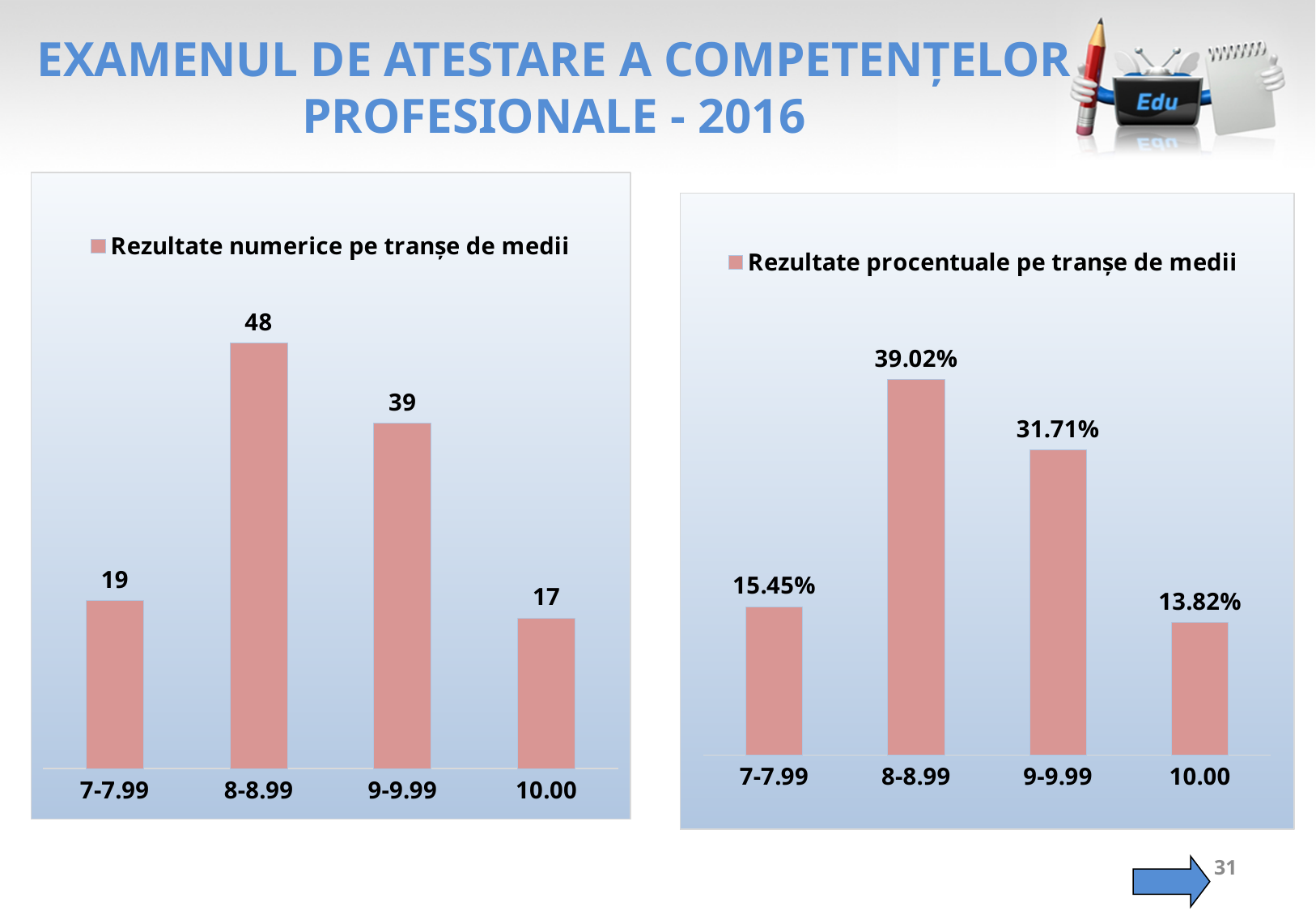
In the left chart (Rezultate numerice pe tranșe de medii), which is larger, the value for 7-7.99 or the value for 10.00? 7-7.99 What kind of chart is the right chart (Rezultate procentuale pe tranșe de medii)? Bar chart In the left chart (Rezultate numerice pe tranșe de medii), what is the value for 10.00? 17 In the right chart (Rezultate procentuale pe tranșe de medii), what is the value for 7-7.99? 15.45% How many series does the legend of the left chart list? 1 What is the legend entry of the left chart? Rezultate numerice pe tranșe de medii In the left chart (Rezultate numerice pe tranșe de medii), which category has the highest value? 8-8.99 In the left chart (Rezultate numerice pe tranșe de medii), what is the difference between the values for 8-8.99 and 9-9.99? 9 How many categories are shown in the right chart (Rezultate procentuale pe tranșe de medii)? 4 In the right chart (Rezultate procentuale pe tranșe de medii), what is the value for 9-9.99? 31.71% In the left chart (Rezultate numerice pe tranșe de medii), what is the value for 8-8.99? 48 In the right chart (Rezultate procentuale pe tranșe de medii), which category has the lowest value? 10.00